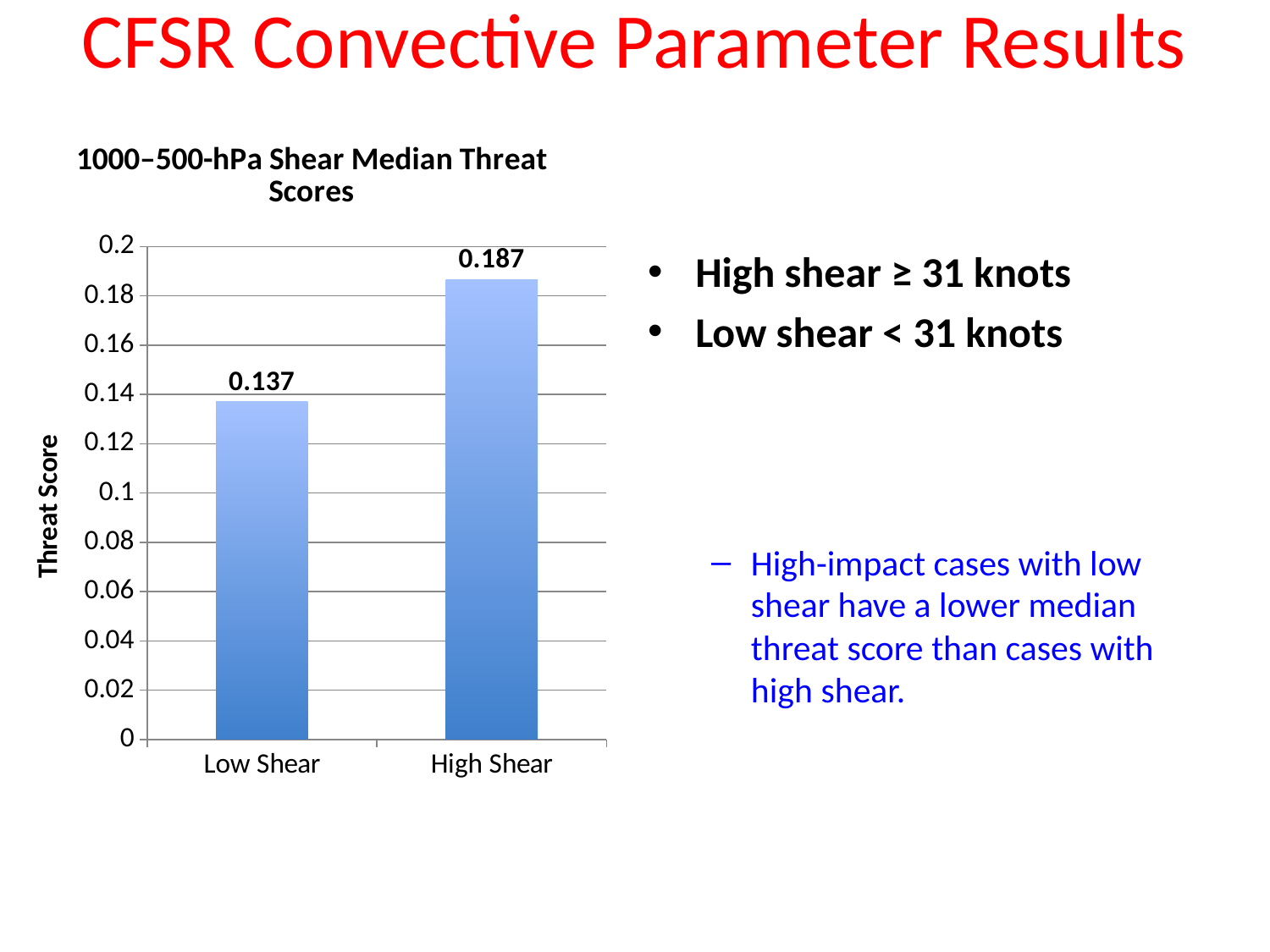
What is the difference between the High Shear and Low Shear median threat scores? 0.050 Which is larger, the threat score for Low Shear or for High Shear? High Shear What is the label of the y axis of the chart? Threat Score Is the value for High Shear greater or less than 0.18? greater What is the median threat score for Low Shear? 0.137 How many categories are shown on the x axis of the chart? 2 What is the median threat score for High Shear? 0.187 What kind of chart is shown on the slide? bar chart Which category has the highest median threat score? High Shear What is the title of the chart? 1000–500-hPa Shear Median Threat Scores Is the value for Low Shear greater or less than 0.14? less Which category has the lowest median threat score? Low Shear